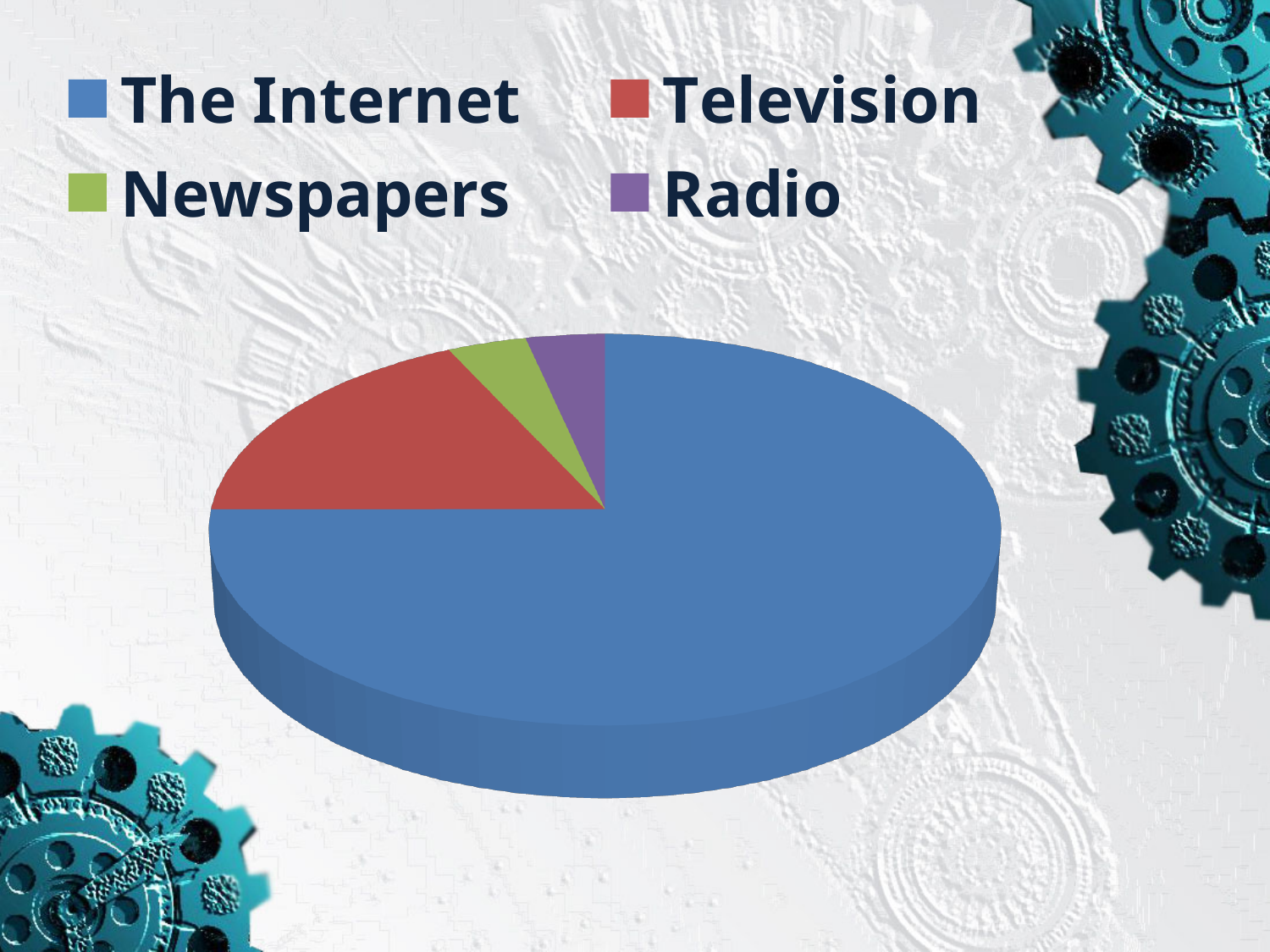
Which category has the largest slice of the pie? The Internet How many slices does the pie chart have? 4 Which category has the second-largest slice of the pie? Television How many entries does the legend list? 4 Which slice is larger, Television or Newspapers? Television Which slice is larger, The Internet or Radio? The Internet Which slice is larger, The Internet or Television? The Internet What colour is the slice for The Internet? blue What kind of chart is shown on the slide? pie chart